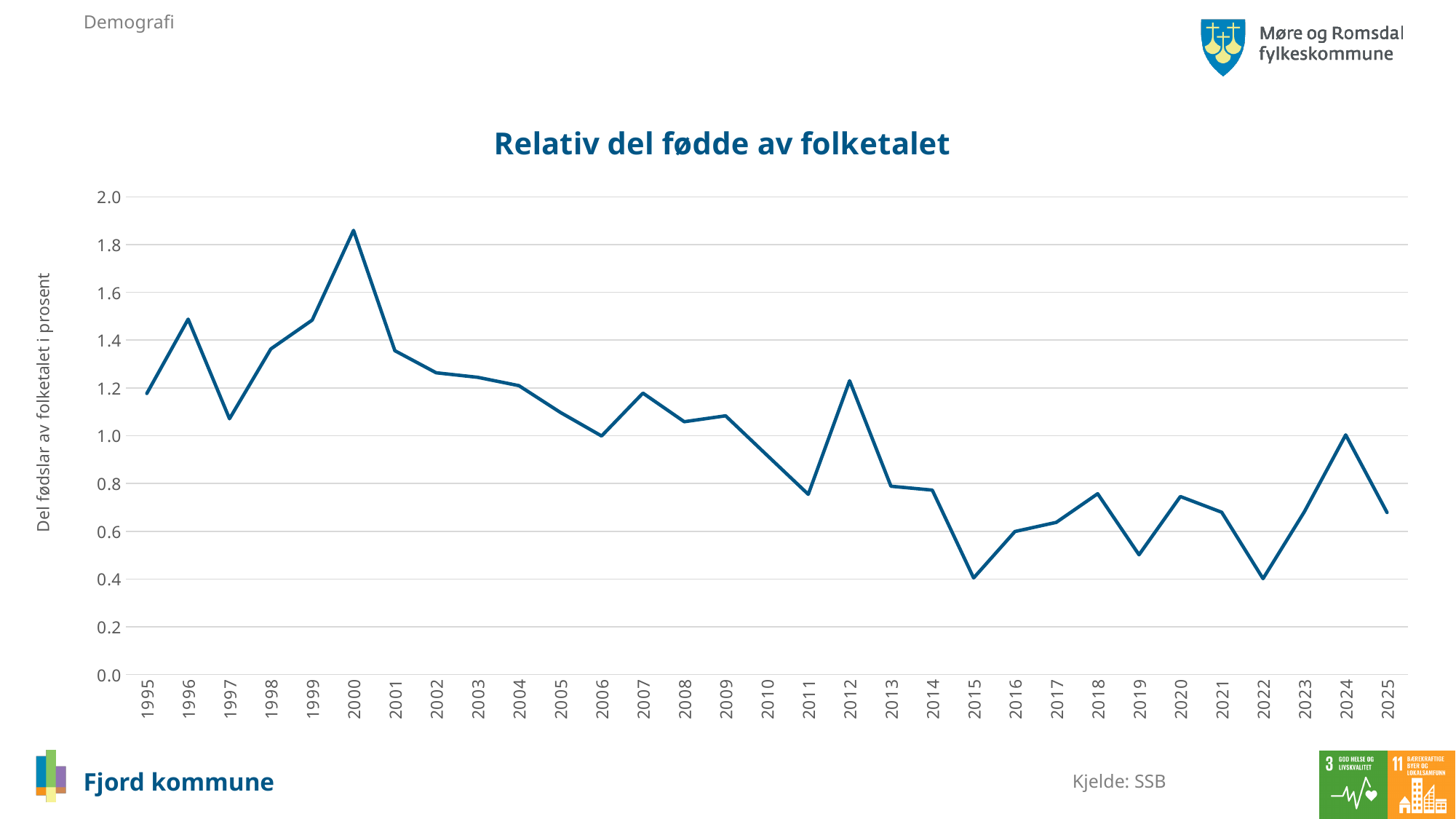
Is the value for 2001 greater or less than 1.4? less What is the title of the chart? Relativ del fødde av folketalet How many years are shown along the x axis? 31 What kind of chart is shown on the slide? line chart Which year has the higher value, 1996 or 1997? 1996 Overall, does the line rise or fall from 1995 to 2025? fall What is the label on the vertical axis of the chart? Del fødslar av folketalet i prosent In which year does the line reach its highest value? 2000 Is the value for 2011 greater or less than 0.8? less Which year has the higher value, 2012 or 2013? 2012 Is the value for 2015 greater or less than 0.6? less